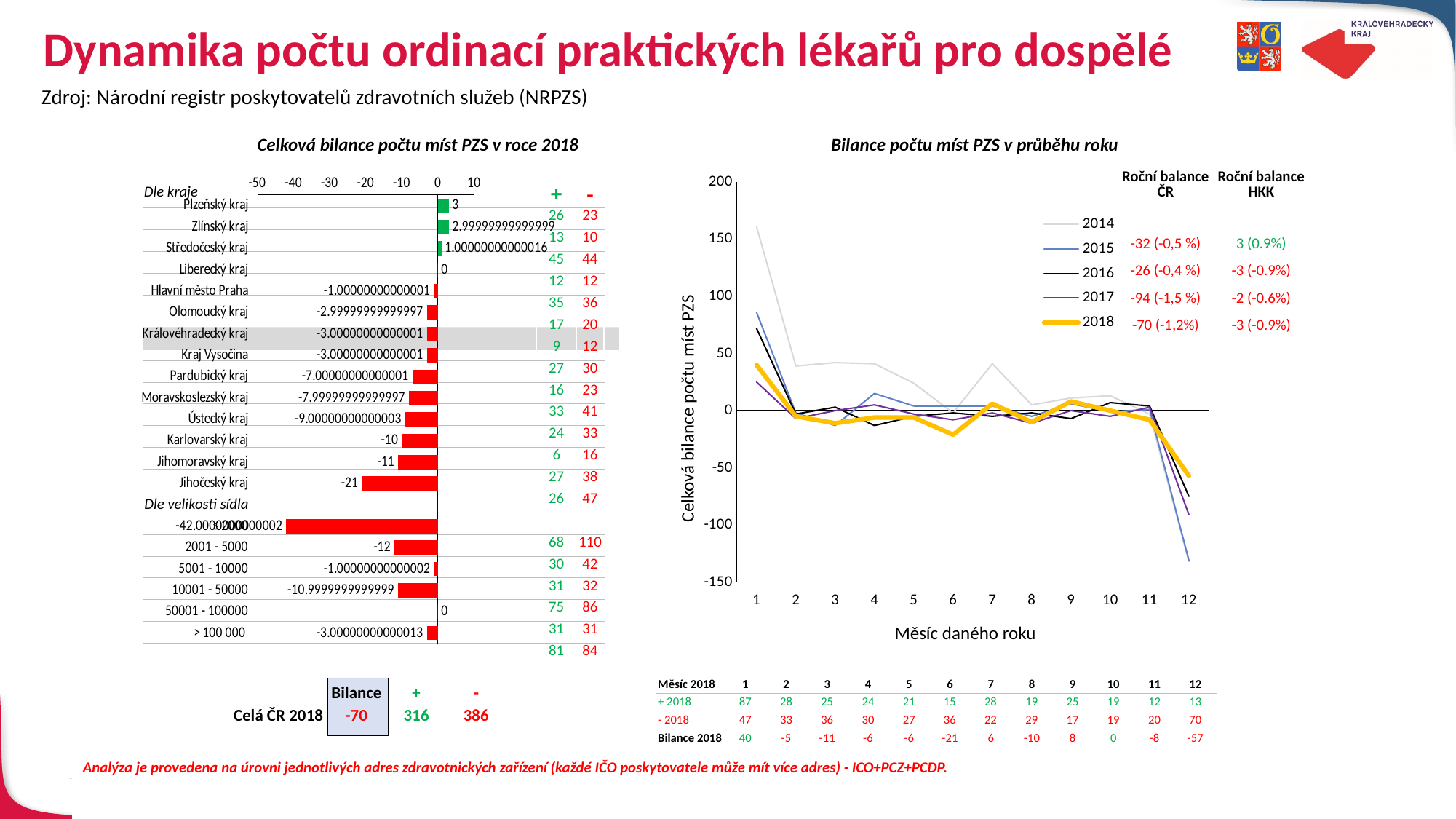
In the right chart 'Bilance počtu míst PZS v průběhu roku', is the 2014 value in month 1 greater or less than 150? greater What kind of chart is the right chart 'Bilance počtu míst PZS v průběhu roku'? line chart In the left chart 'Celková bilance počtu míst PZS v roce 2018', which has the lower value, Jihočeský kraj or Jihomoravský kraj? Jihočeský kraj In the left chart 'Celková bilance počtu míst PZS v roce 2018', which region (Dle kraje) has the lowest value? Jihočeský kraj In the left chart 'Celková bilance počtu míst PZS v roce 2018', what is the value for Plzeňský kraj? 3 What kind of chart is the left chart titled 'Celková bilance počtu míst PZS v roce 2018'? bar chart In the left chart 'Celková bilance počtu míst PZS v roce 2018', what is the value for Jihočeský kraj? -21 In the right chart 'Bilance počtu míst PZS v průběhu roku', what is the 2018 balance (Bilance 2018) in month 12? -57 In the left chart 'Celková bilance počtu míst PZS v roce 2018', what is the value for the settlement size category 2001 - 5000? -12 In the right chart 'Bilance počtu míst PZS v průběhu roku', is the 2015 value in month 12 greater or less than -100? less In the left chart 'Celková bilance počtu míst PZS v roce 2018', what is the difference between the values for Karlovarský kraj and Jihočeský kraj? 11 How many series does the legend of the right chart 'Bilance počtu míst PZS v průběhu roku' list? 5